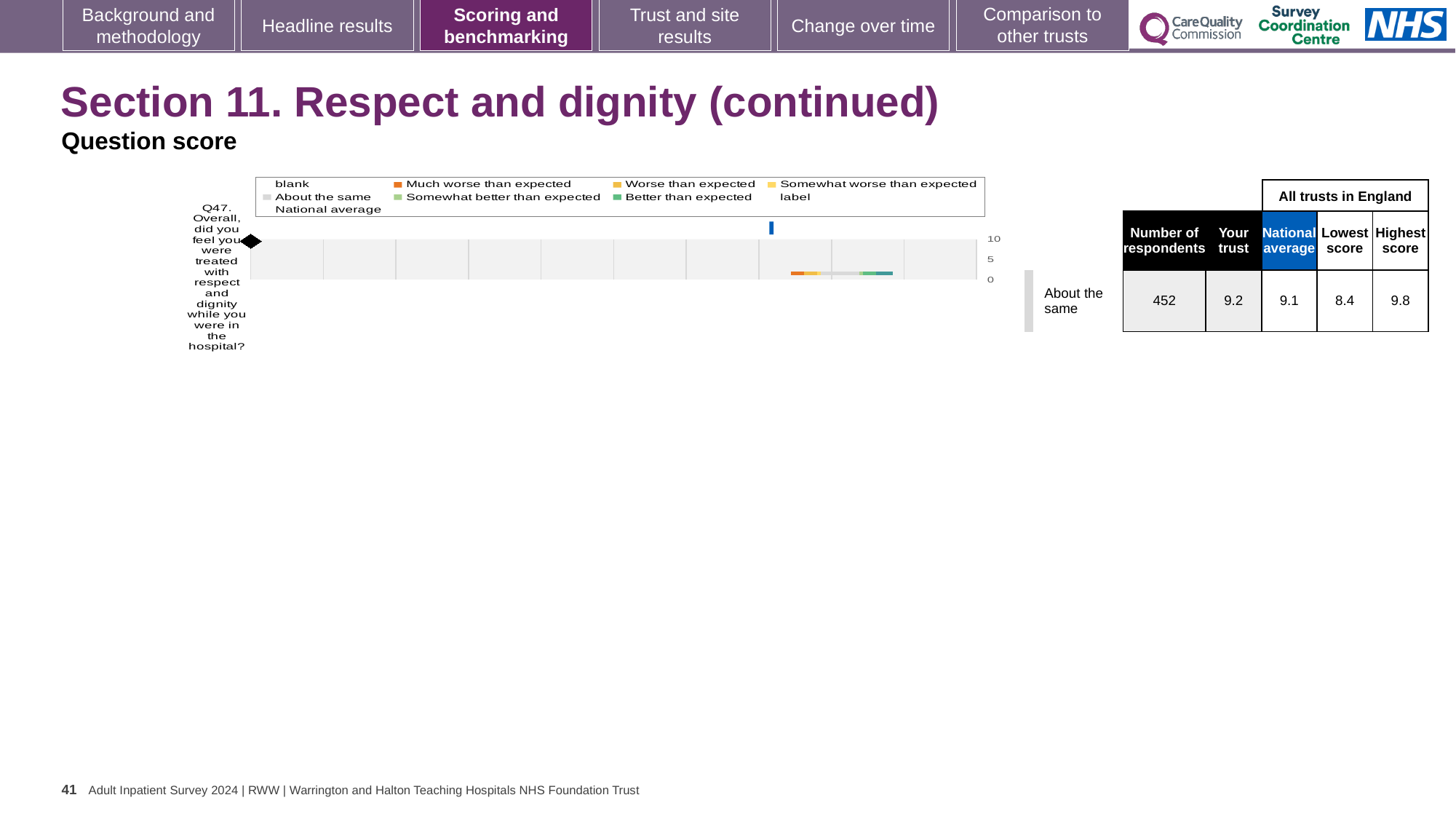
In the table beside the chart, what is the Highest score among all trusts in England for Q47? 9.8 In the table beside the chart, how many respondents answered Q47? 452 Which legend entry is shown in orange? Much worse than expected How many questions (categories) are plotted in the chart? 1 In the table beside the chart, what is the 'Your trust' score for Q47? 9.2 What is the difference between the Highest score and the Lowest score for Q47 in the table? 1.4 Which is larger for Q47: the 'Your trust' score or the National average? Your trust What is the highest tick value shown on the chart's score axis? 10 What kind of chart is shown for Q47 on this slide? bar chart What benchmarking category is the trust's Q47 score assigned to? About the same In the table beside the chart, what is the National average score for Q47? 9.1 In the table beside the chart, what is the Lowest score among all trusts in England for Q47? 8.4